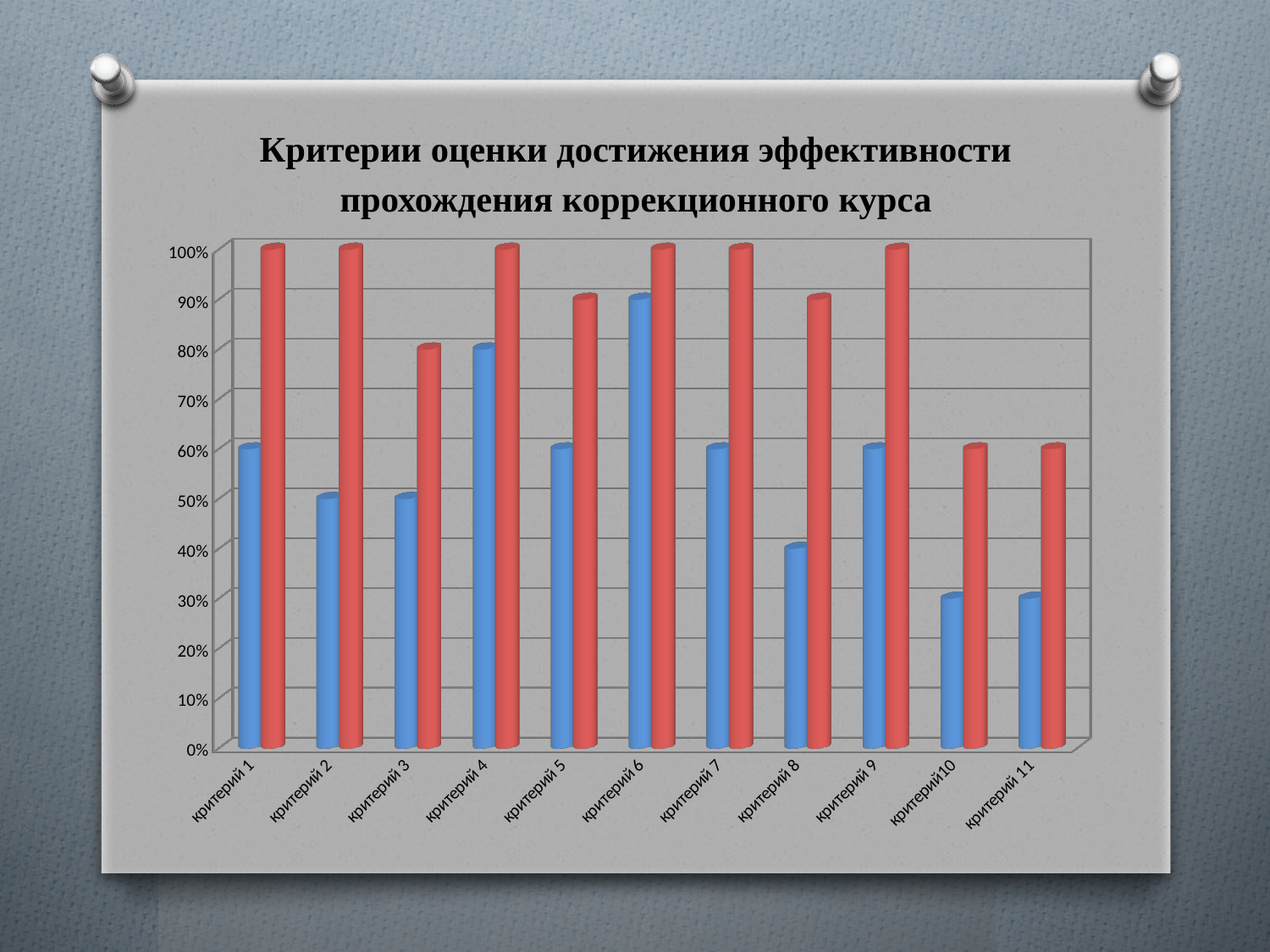
Which has the larger blue bar, критерий 4 or критерий 2? критерий 4 How many categories (критерии) are shown on the x axis? 11 What is the value of the blue bar for критерий 6? 90% What is the difference between the red bar and the blue bar for критерий 1? 40% What is the value of the blue bar for критерий 10? 30% Which category has the highest blue bar? критерий 6 What two colours are used for the bars in the chart? blue and red Is the red bar for критерий 5 greater or less than 80%? greater What is the title of the chart? Критерии оценки достижения эффективности прохождения коррекционного курса Is the blue bar for критерий 8 greater or less than 50%? less What is the value of the red bar for критерий 3? 80% What kind of chart is shown on the slide? bar chart